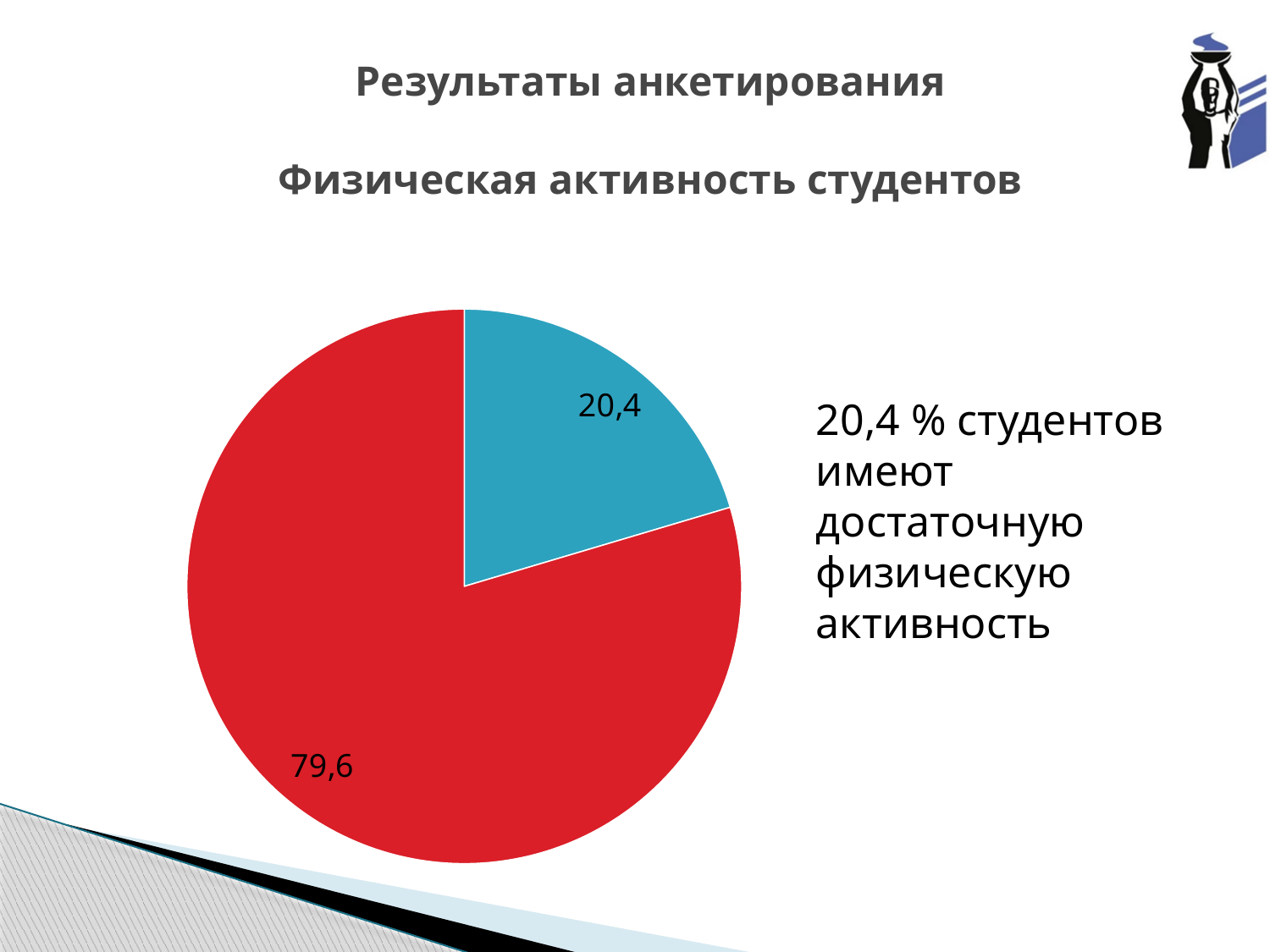
What is the difference between the red slice and the blue slice values? 59,2 According to the slide text, what percentage of students have sufficient physical activity? 20,4 % What value is printed on the blue slice of the pie chart? 20,4 Which slice of the pie chart is the smallest? the blue slice (20,4) What kind of chart is shown on the slide? pie chart Which is larger, the blue slice or the red slice? the red slice What is the title of the chart on the slide? Физическая активность студентов What share of the pie does the blue slice represent? 20,4 What do the two slice values of the pie chart add up to? 100 Which slice of the pie chart is the largest? the red slice (79,6) How many slices does the pie chart have? 2 What value is printed on the red slice of the pie chart? 79,6